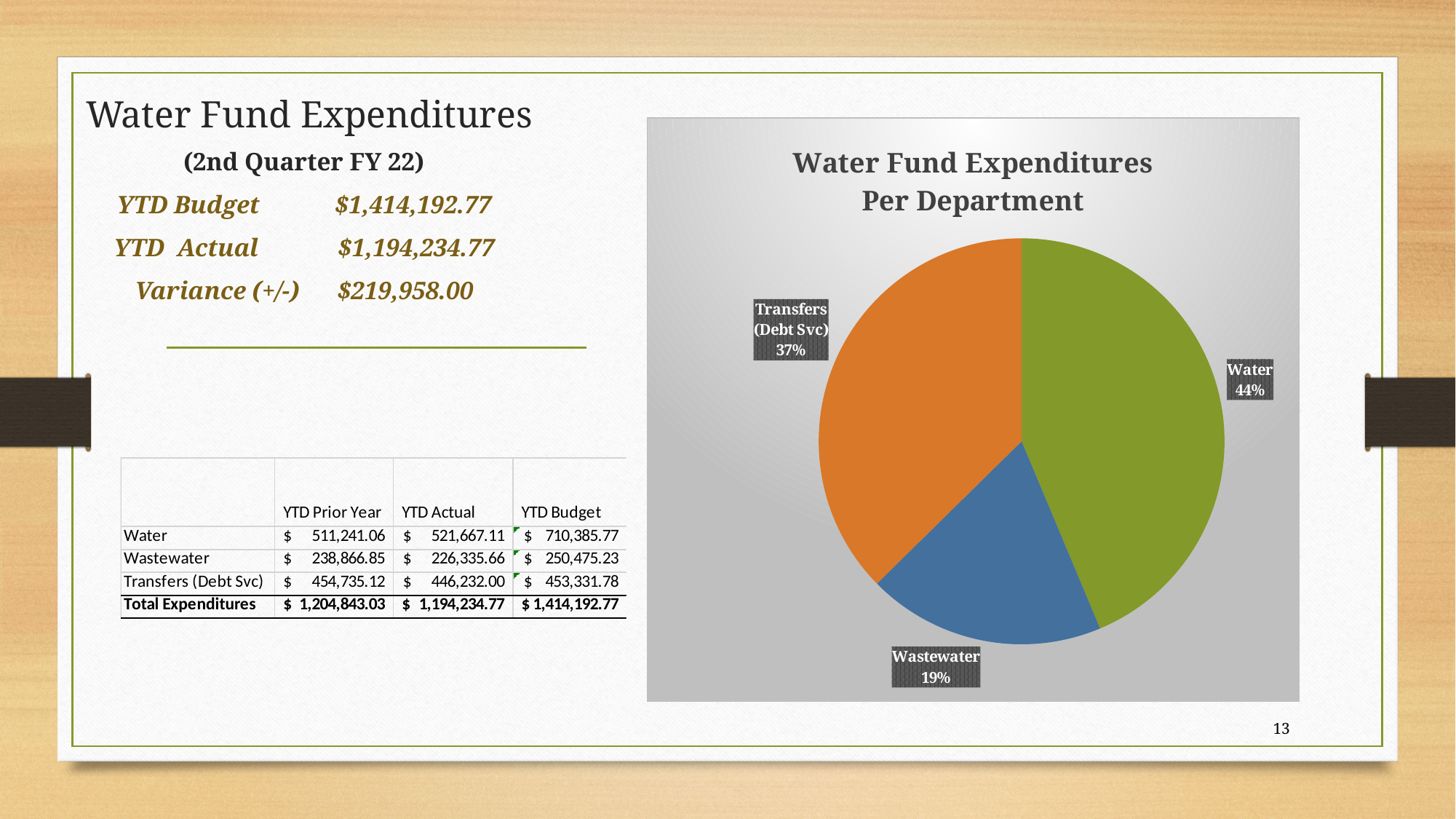
What type of chart is shown on the slide? Pie chart Which department has the largest slice of the pie? Water What colour is the Wastewater slice? Blue What is the title of the chart? Water Fund Expenditures Per Department Which department has the smallest slice of the pie? Wastewater What share of the pie does Transfers (Debt Svc) represent? 37% What share of the pie does Wastewater represent? 19% What is the difference in percentage points between the Water slice and the Wastewater slice? 25 How many slices does the pie chart have? 3 Which slice is larger, Wastewater or Transfers (Debt Svc)? Transfers (Debt Svc) What is the difference in percentage points between the Water slice and the Transfers (Debt Svc) slice? 7 What share of the pie does Water represent? 44%